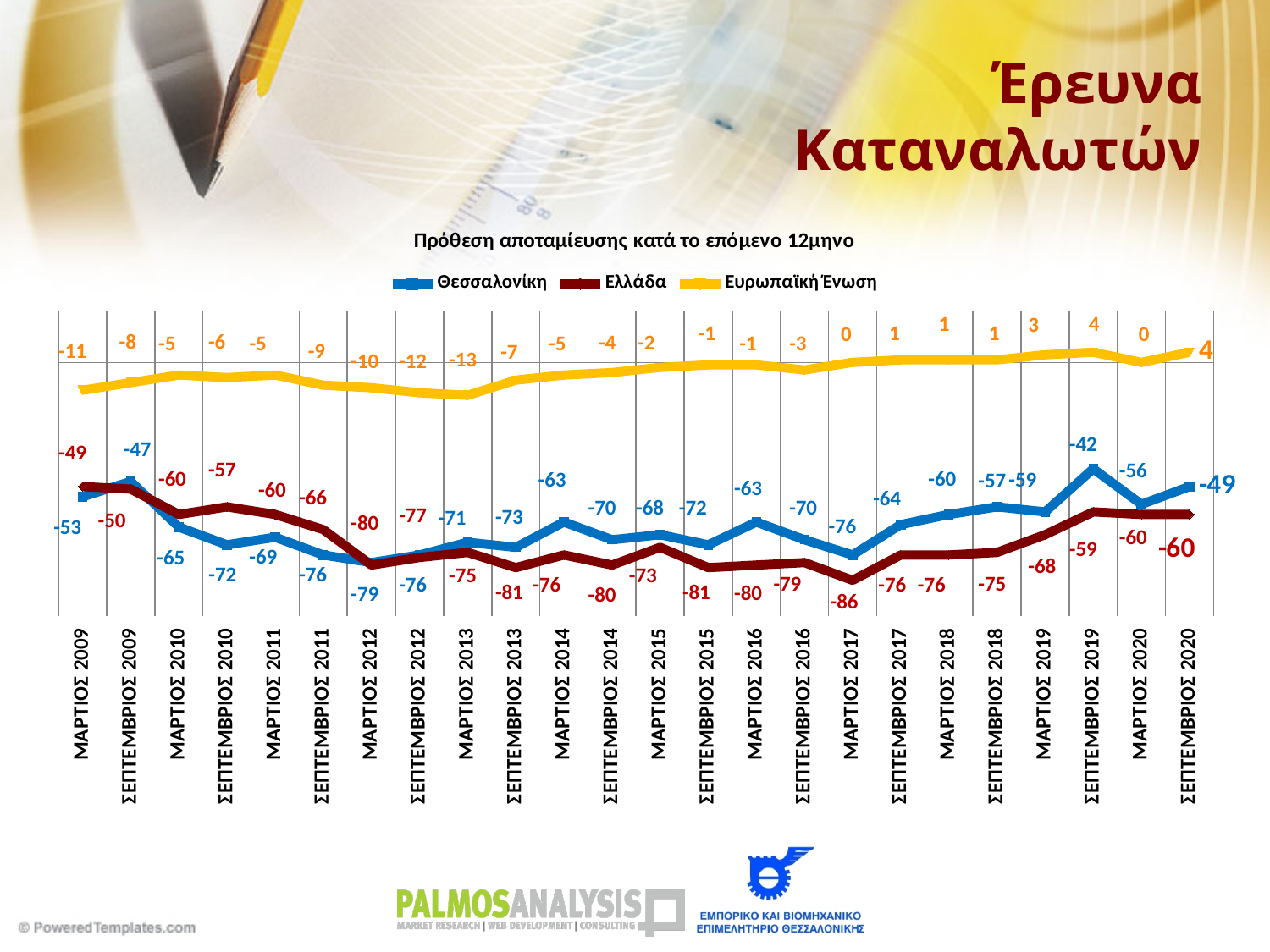
What is the value for Θεσσαλονίκη at ΣΕΠΤΕΜΒΡΙΟΣ 2019? -42 What kind of chart is shown on the slide? line chart At ΜΑΡΤΙΟΣ 2018, which series has the higher value, Θεσσαλονίκη or Ελλάδα? Θεσσαλονίκη At which time point does the Θεσσαλονίκη series reach its highest value? ΣΕΠΤΕΜΒΡΙΟΣ 2019 How many time points are plotted along the x axis? 24 What is the value for Ελλάδα at ΜΑΡΤΙΟΣ 2017? -86 What is the difference between the Θεσσαλονίκη and Ελλάδα values at ΣΕΠΤΕΜΒΡΙΟΣ 2020? 11 What is the value for Ευρωπαϊκή Ένωση at ΣΕΠΤΕΜΒΡΙΟΣ 2020? 4 At which time point does the Ελλάδα series reach its lowest value? ΜΑΡΤΙΟΣ 2017 What is the title of the chart? Πρόθεση αποταμίευσης κατά το επόμενο 12μηνο At which time point does the Ευρωπαϊκή Ένωση series reach its lowest value? ΜΑΡΤΙΟΣ 2013 How many series does the legend list? 3